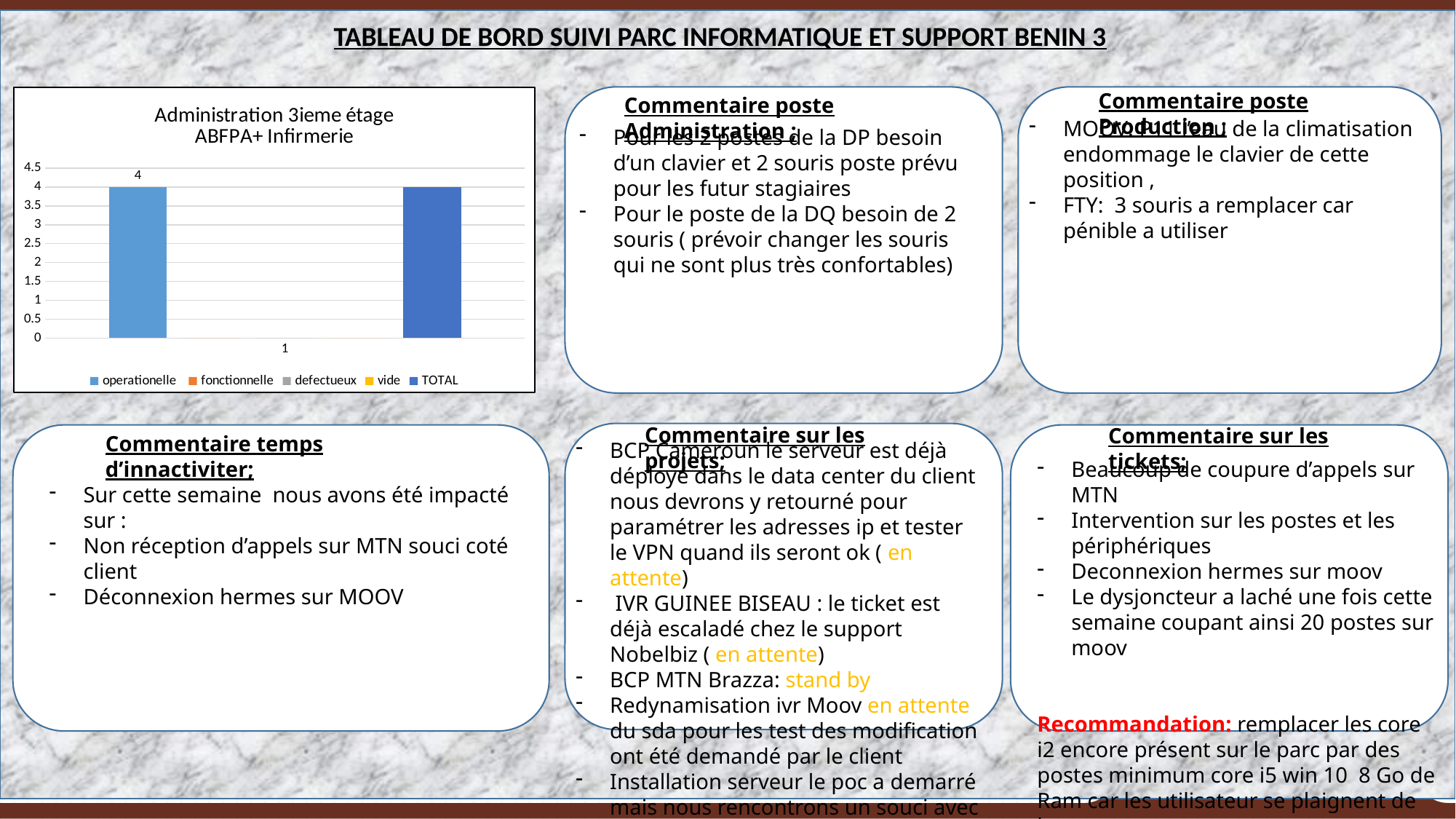
What is the value of the operationelle bar? 4 Is the value for TOTAL greater or less than 2? greater How many categories are shown on the x axis of the chart? 1 What is the difference between the operationelle value and the TOTAL value? 0 What is the highest value shown on the chart's y axis? 4.5 Is the value for operationelle greater or less than 3? greater How many series does the chart legend list? 5 Which is larger, the operationelle bar or the fonctionnelle bar? operationelle What is the title of the chart? Administration 3ieme étage ABFPA+ Infirmerie What is the value of the TOTAL bar? 4 What kind of chart is shown on the slide? bar chart